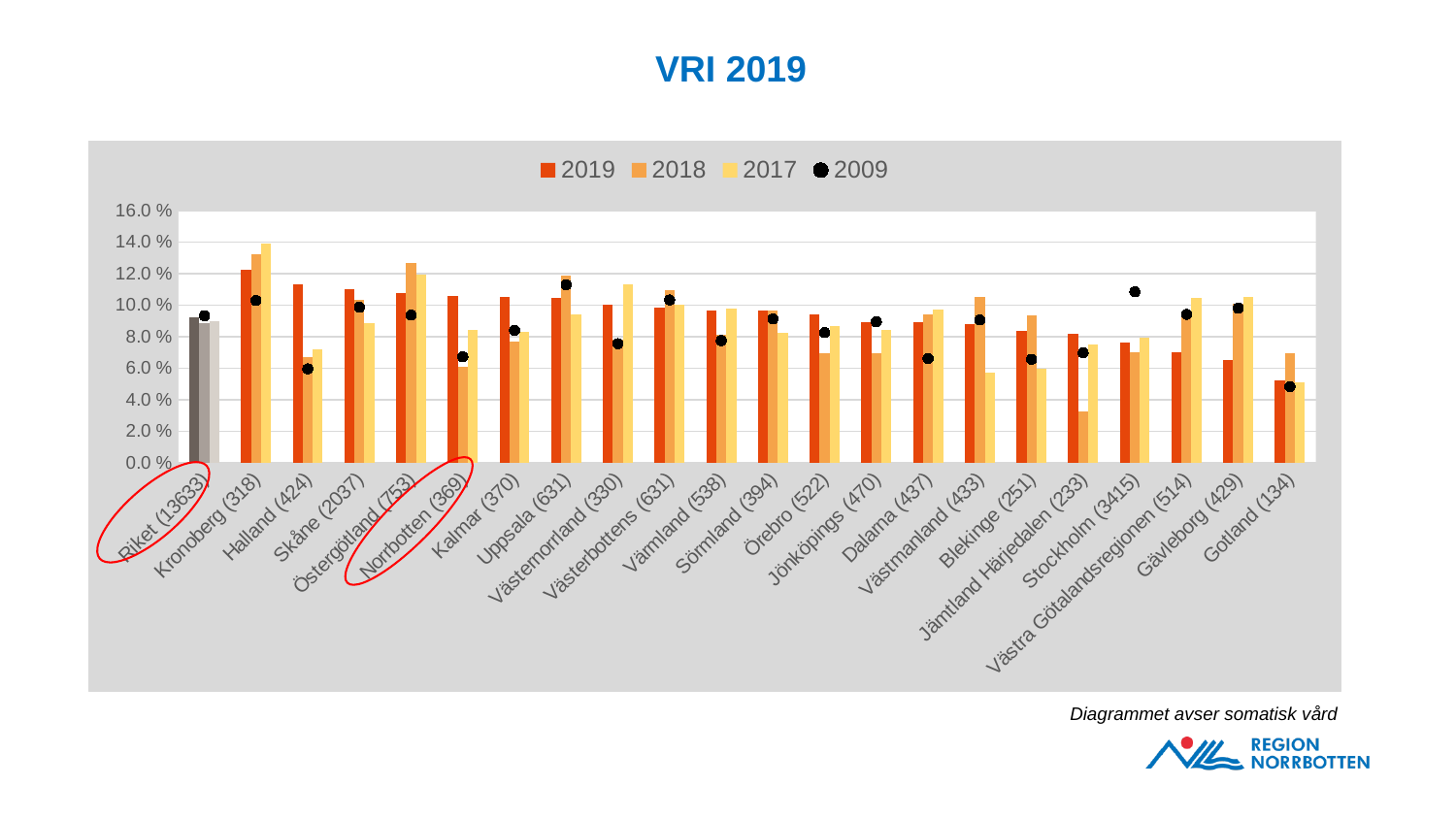
How many series does the legend list? 4 Do the 2019 values generally rise or fall from left to right across the categories? fall Is the 2019 value for Gotland (134) greater or less than 6.0 %? less Is the 2018 value for Jämtland Härjedalen (233) greater or less than 4.0 %? less What kind of chart is shown on the slide? Bar chart (with dot markers for 2009) Which category has the lowest 2019 value? Gotland (134) Which category has the lowest 2018 value? Jämtland Härjedalen (233) Is the 2017 value for Kronoberg (318) greater or less than 12.0 %? greater Which category has the highest 2019 value? Kronoberg (318) How many categories are shown along the x axis? 22 For Halland (424), which is larger: the 2019 value or the 2017 value? 2019